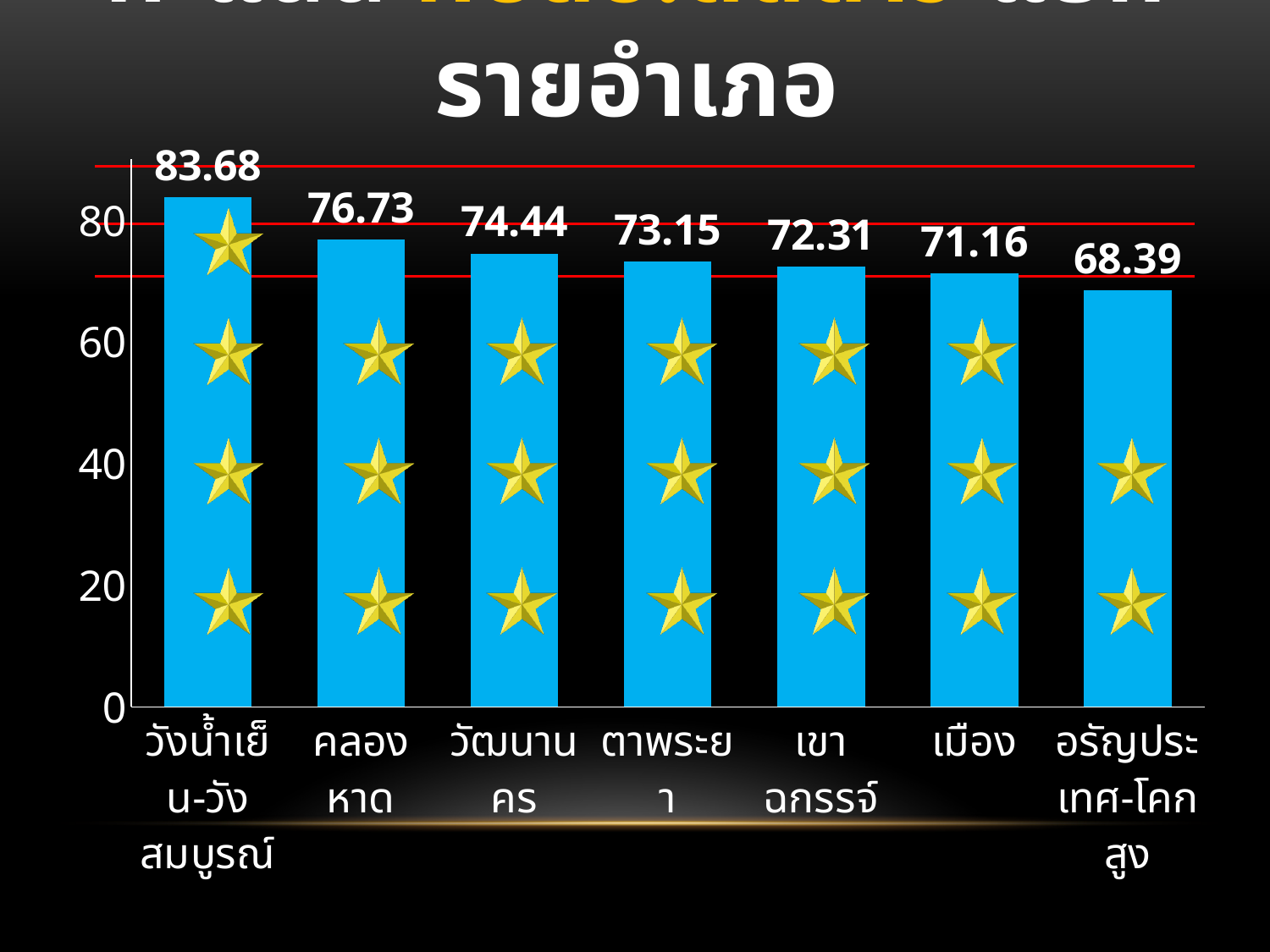
Is the value for อรัญประเทศ-โคกสูง greater or less than 80? less What is the difference between the values for วังน้ำเย็น-วังสมบูรณ์ and อรัญประเทศ-โคกสูง? 15.29 What is the value for เมือง? 71.16 Do the values rise or fall from left to right along the x axis? fall What is the value for ตาพระยา? 73.15 Which category has the highest value? วังน้ำเย็น-วังสมบูรณ์ How many categories are shown in the chart? 7 Which category has the lowest value? อรัญประเทศ-โคกสูง Which is larger, the value for เขาฉกรรจ์ or the value for เมือง? เขาฉกรรจ์ What is the difference between the values for คลองหาด and วัฒนานคร? 2.29 What is the value for คลองหาด? 76.73 What kind of chart is shown on the slide? bar chart